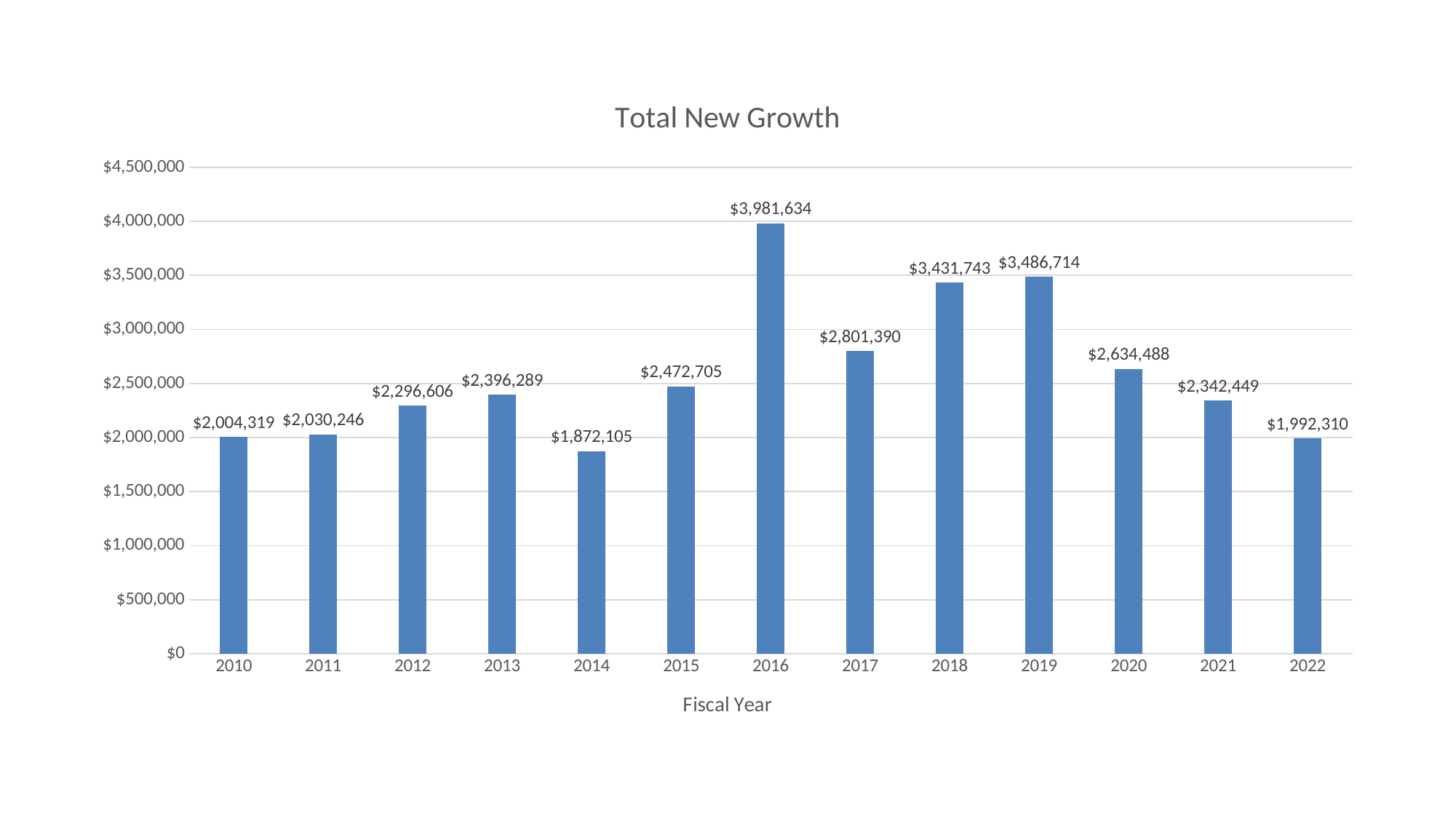
Is the Total New Growth value for 2018 greater or less than $3,000,000? greater What is the Total New Growth value for fiscal year 2022? $1,992,310 Which fiscal year has the lowest Total New Growth? 2014 What kind of chart is shown on the slide? Bar chart How many fiscal years are shown on the chart? 13 What is the difference between the Total New Growth values for 2016 and 2014? $2,109,529 What is the difference between the Total New Growth values for 2019 and 2018? $54,971 Do the Total New Growth values rise or fall from 2019 to 2022? Fall What is the Total New Growth value for fiscal year 2014? $1,872,105 Which fiscal year has a larger Total New Growth, 2017 or 2020? 2017 What is the Total New Growth value for fiscal year 2016? $3,981,634 Which fiscal year has the highest Total New Growth? 2016